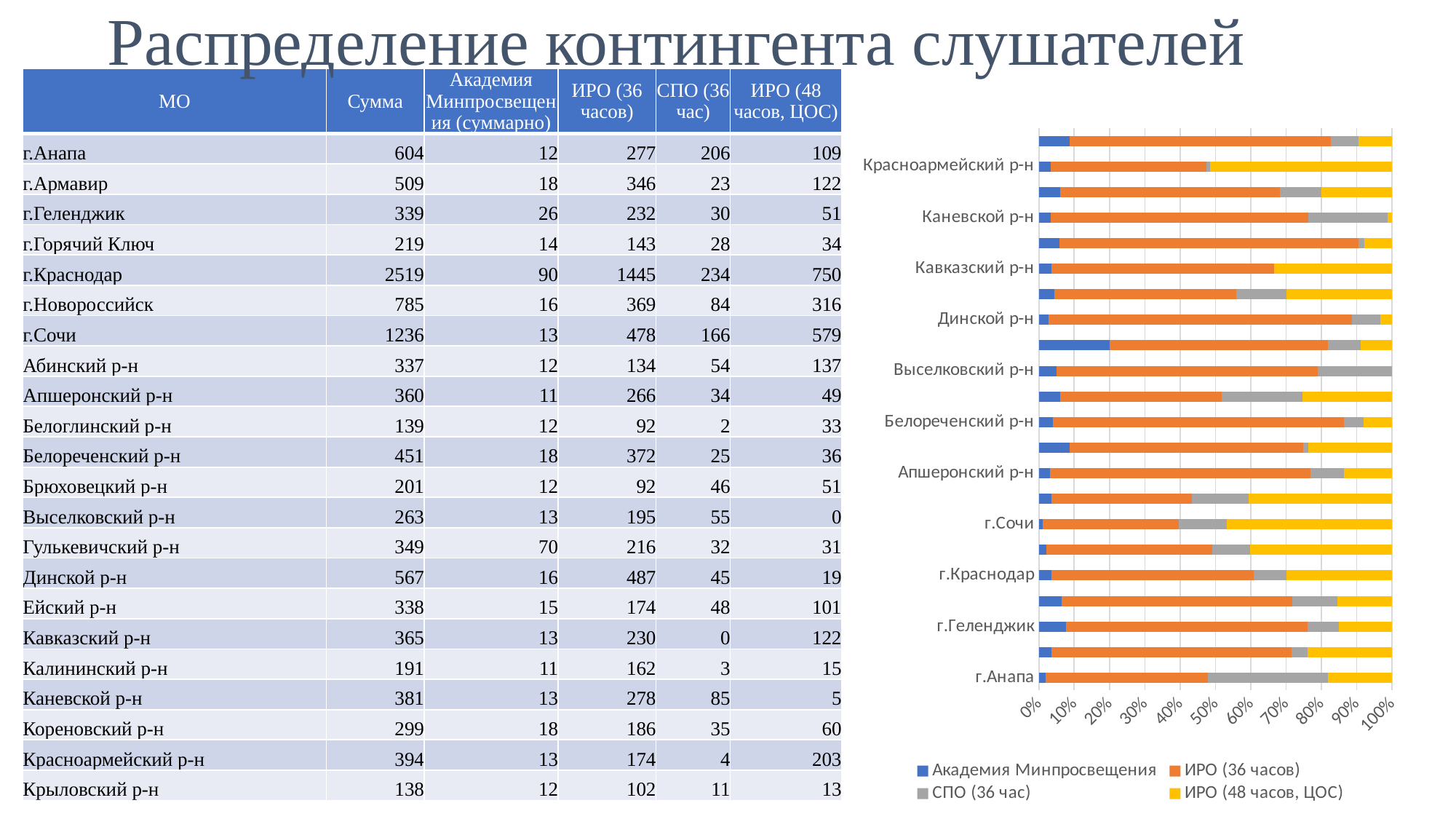
How many series does the chart legend list? 4 In the chart, is the Академия Минпросвещения share for г.Сочи greater or less than 10%? less In the chart, is the ИРО (48 часов, ЦОС) share for Красноармейский р-н greater or less than 40%? greater How many bars are plotted in the chart? 22 In the chart, is the ИРО (36 часов) share for Белореченский р-н greater or less than 70%? greater In the chart, which has the larger ИРО (48 часов, ЦОС) share: г.Сочи or Каневской р-н? г.Сочи What is the highest value shown on the chart's horizontal axis? 100% In the chart, which has the larger ИРО (36 часов) share: Кавказский р-н or г.Сочи? Кавказский р-н What kind of chart is shown on the right of the slide? stacked bar chart In the chart, which colour represents the series ИРО (48 часов, ЦОС)? yellow